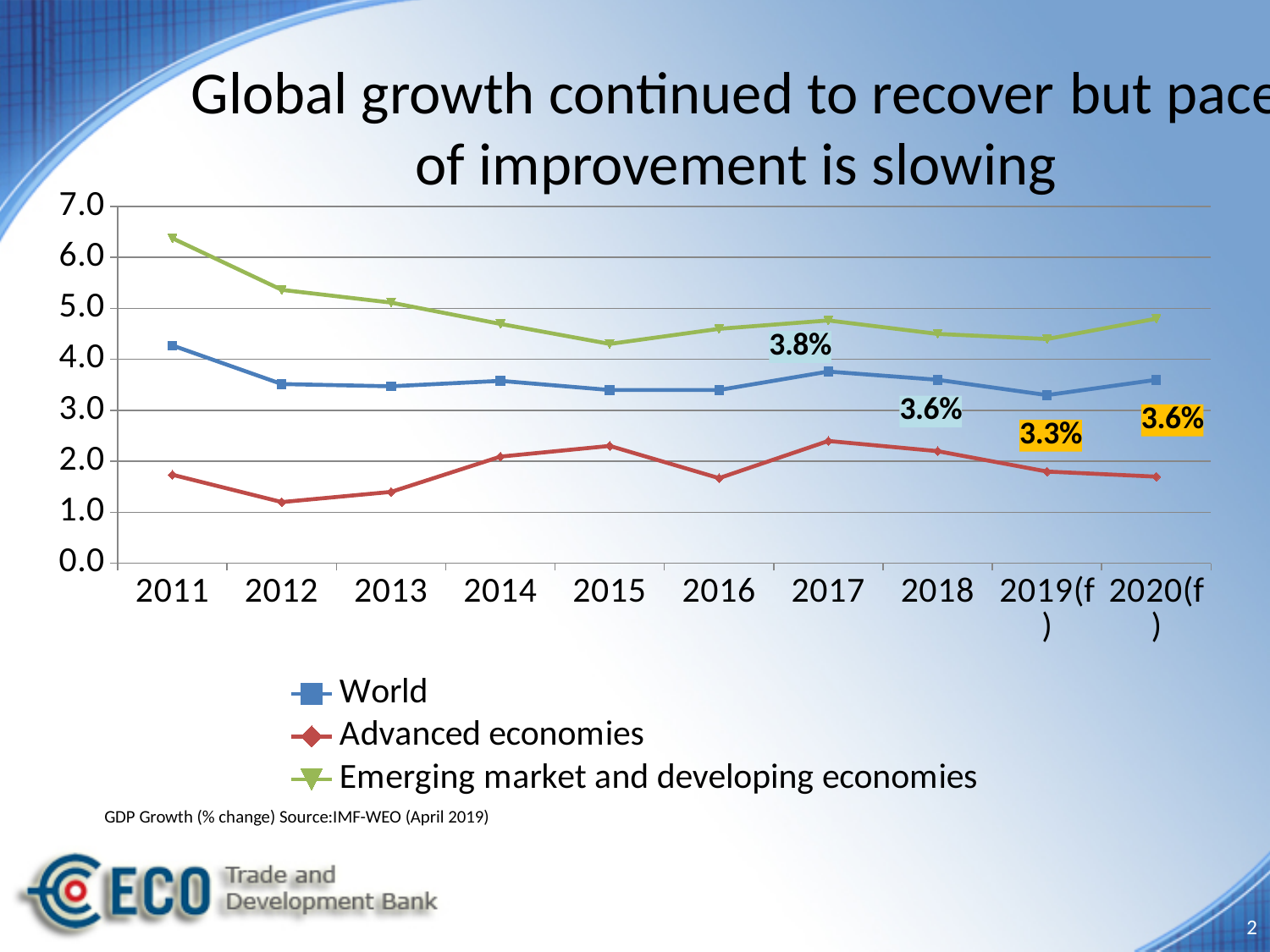
What is the labelled World growth value for 2020(f)? 3.6% What kind of chart is shown on the slide? line chart In which year is the Advanced economies line at its lowest? 2012 How many series does the legend list? 3 How many years are shown along the x axis? 10 What is the title of the slide? Global growth continued to recover but pace of improvement is slowing Which series has the highest value in 2015? Emerging market and developing economies Does the Emerging market and developing economies line rise or fall from 2011 to 2015? fall What is the labelled World growth value for 2019(f)? 3.3% Is the value for Emerging market and developing economies in 2011 greater or less than 6.0? greater By how much does the labelled World value for 2017 exceed the labelled value for 2019(f)? 0.5% What is the labelled World growth value for 2017? 3.8%